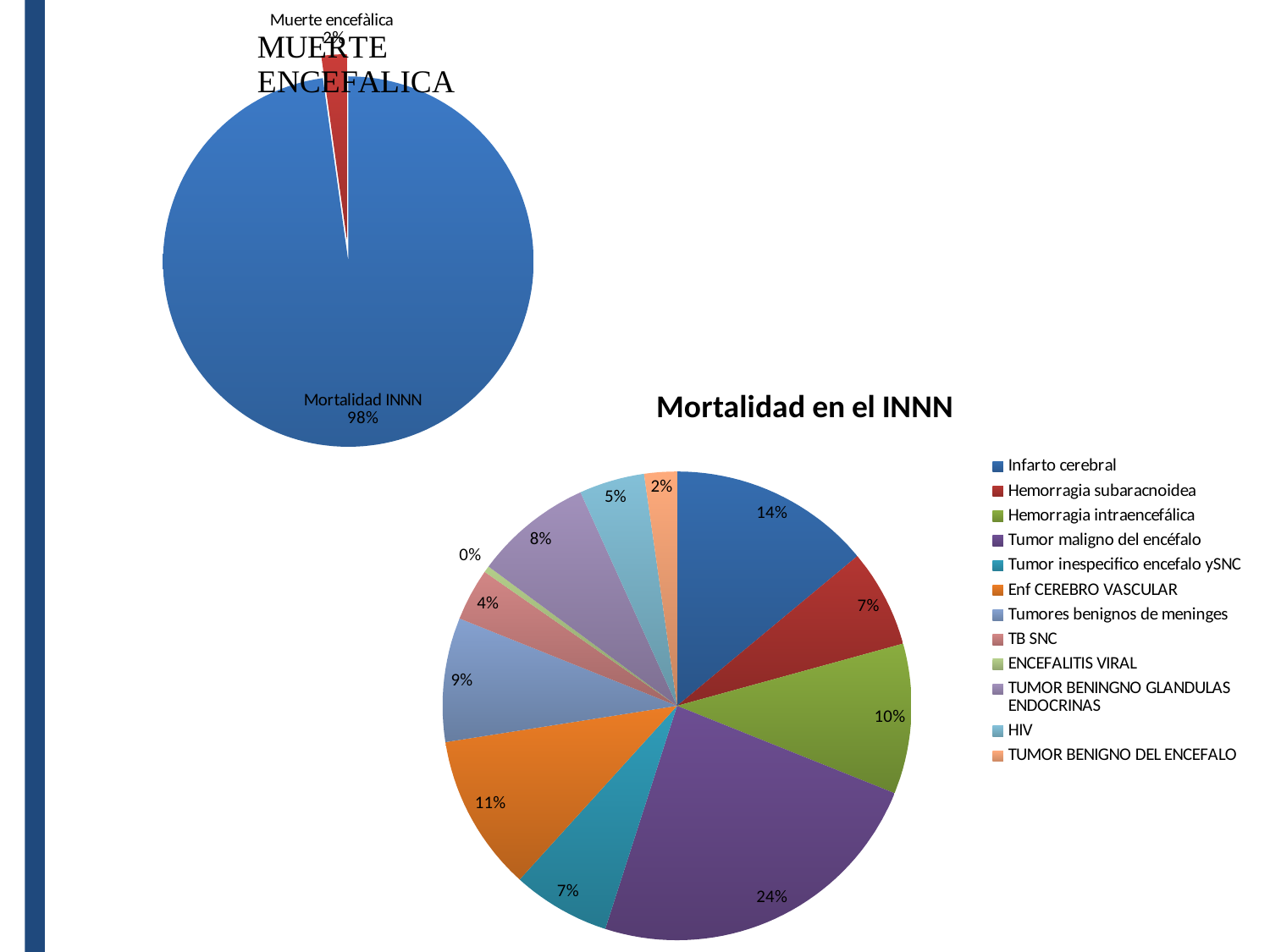
In the 'Mortalidad en el INNN' pie chart, what share does Infarto cerebral have? 14% How many entries does the legend of the 'Mortalidad en el INNN' pie chart list? 12 In the 'MUERTE ENCEFALICA' pie chart at the top left, what share does Muerte encefàlica have? 2% In the 'Mortalidad en el INNN' pie chart, what is the difference between the shares of Tumor maligno del encéfalo and Hemorragia intraencefálica? 14% In the 'MUERTE ENCEFALICA' pie chart at the top left, what share does Mortalidad INNN have? 98% In the 'Mortalidad en el INNN' pie chart, what share does Enf CEREBRO VASCULAR have? 11% What type of chart is the 'Mortalidad en el INNN' chart? Pie chart In the 'Mortalidad en el INNN' pie chart, which category has the largest share? Tumor maligno del encéfalo In the 'Mortalidad en el INNN' pie chart, which is larger: Tumores benignos de meninges or TUMOR BENINGNO GLANDULAS ENDOCRINAS? Tumores benignos de meninges In the 'Mortalidad en el INNN' pie chart, what share does Tumor maligno del encéfalo have? 24% In the 'Mortalidad en el INNN' pie chart, what share does HIV have? 5% In the 'Mortalidad en el INNN' pie chart, which category has the smallest share? ENCEFALITIS VIRAL